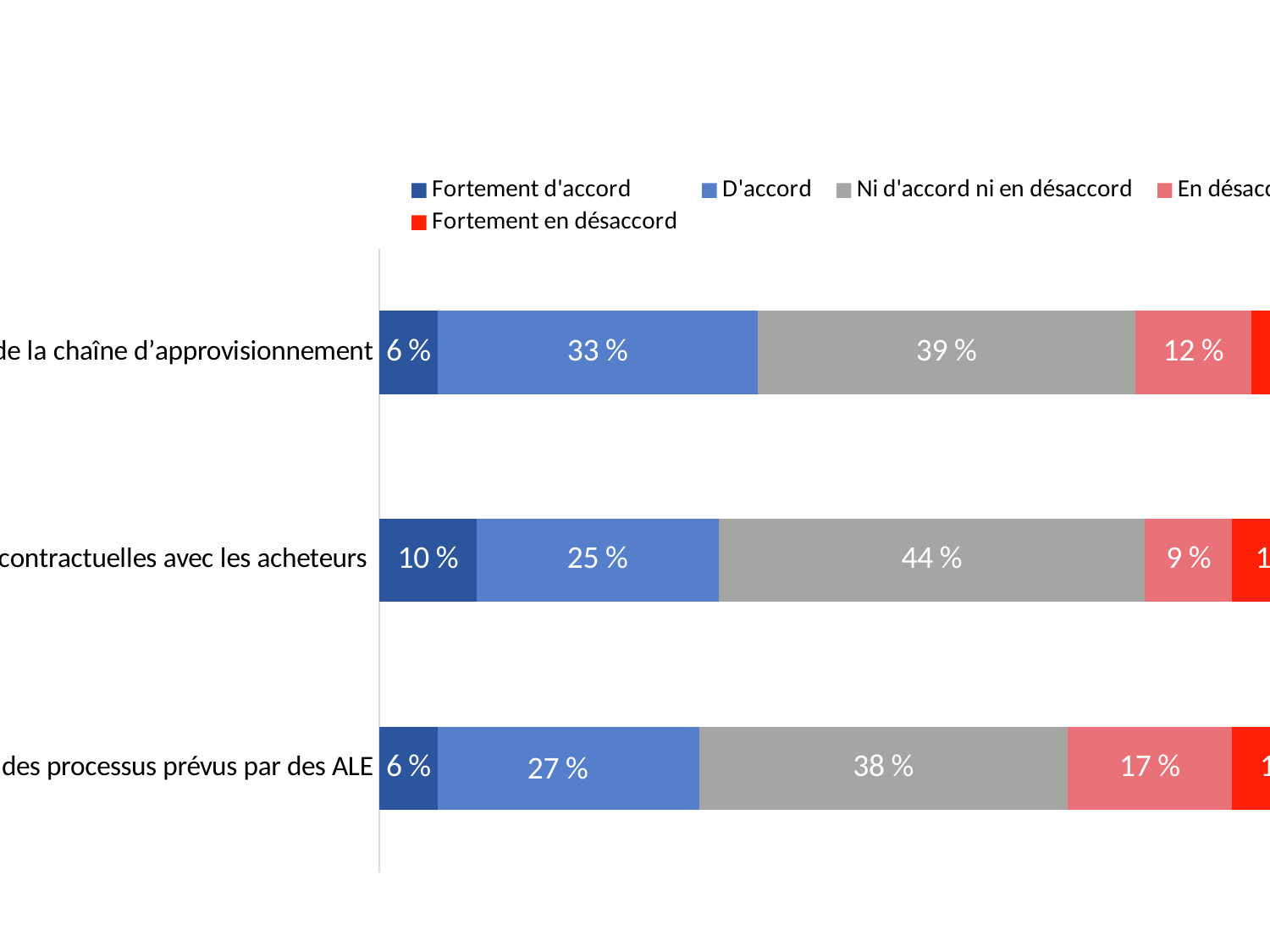
What is the 'Ni d'accord ni en désaccord' value for the bar labelled '…contractuelles avec les acheteurs'? 44 % How many series does the legend list? 5 What is the 'En désaccord' (light red) value for the bar labelled '…des processus prévus par des ALE'? 17 % Which bar has the lowest 'D'accord' value? …contractuelles avec les acheteurs How many categories (bars) does the chart show? 3 What kind of chart is shown on the slide? Stacked bar chart Which is larger: the 'Fortement d'accord' value for '…contractuelles avec les acheteurs' or for '…de la chaîne d'approvisionnement'? …contractuelles avec les acheteurs What is the 'D'accord' value for the bar labelled '…de la chaîne d'approvisionnement'? 33 % What is the difference between the 'D'accord' values for '…de la chaîne d'approvisionnement' and '…des processus prévus par des ALE'? 6 % What is the 'Fortement d'accord' value for the bar labelled '…des processus prévus par des ALE'? 6 % Which legend entry is shown in grey? Ni d'accord ni en désaccord Which bar has the highest 'Ni d'accord ni en désaccord' value? …contractuelles avec les acheteurs